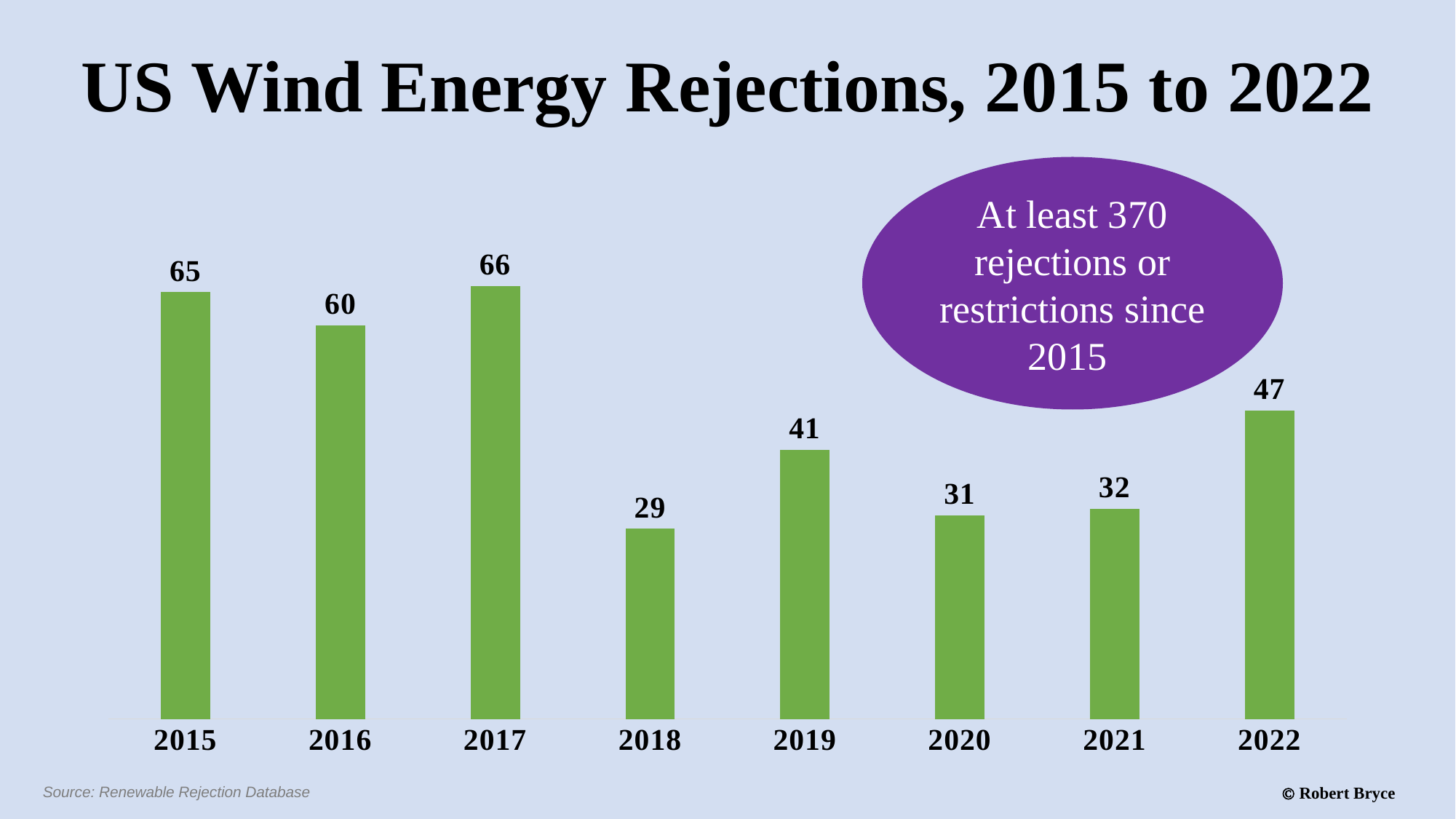
Which year has the lowest value? 2018 Which year has the highest value? 2017 What is the difference between the values for 2017 and 2018? 37 Do the values rise or fall from 2020 to 2022? rise What is the value for 2022? 47 What is the value for 2015? 65 Which is larger, the value for 2019 or the value for 2020? 2019 How many years are shown on the chart? 8 What is the value for 2018? 29 What is the difference between the values for 2022 and 2021? 15 What kind of chart is this? bar chart What is the title of the chart? US Wind Energy Rejections, 2015 to 2022